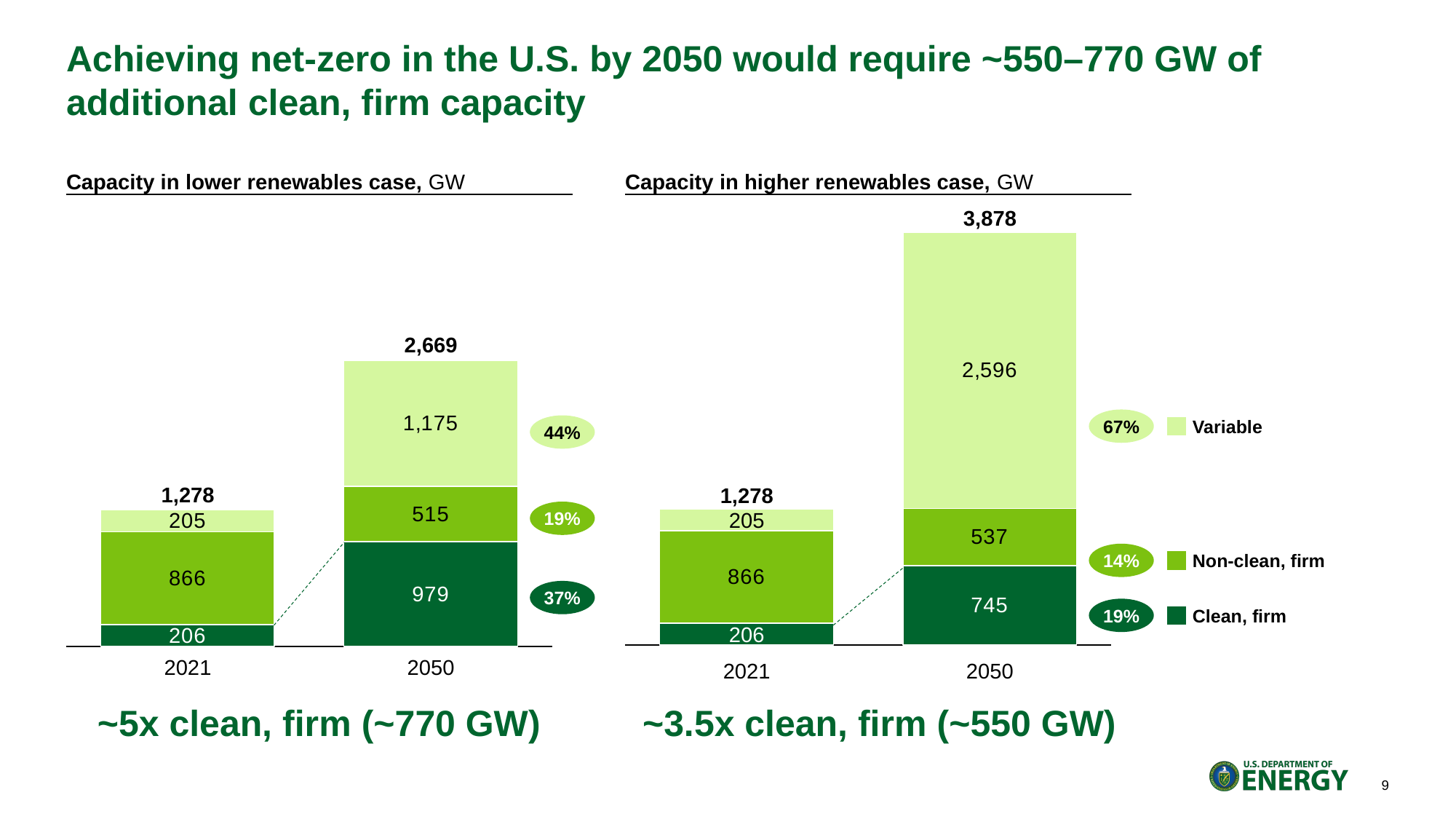
What kind of chart is the 'Capacity in higher renewables case' chart? Stacked bar chart In the 'Capacity in lower renewables case' chart, which is larger in 2050: Variable or Non-clean, firm capacity? Variable In the 'Capacity in higher renewables case' chart, what is the total capacity of the 2050 bar? 3,878 In the 'Capacity in higher renewables case' chart, what share of the 2050 bar is Variable capacity? 67% In the 'Capacity in higher renewables case' chart, what is the difference between the Clean, firm capacity in 2050 and in 2021? 539 In the 'Capacity in lower renewables case' chart, how many years are shown on the x axis? 2 In the 'Capacity in lower renewables case' chart, what is the Non-clean, firm capacity in 2021? 866 How many series does the legend list? 3 In the 'Capacity in lower renewables case' chart, what is the Clean, firm capacity in 2050? 979 In the 'Capacity in lower renewables case' chart, what share of the 2050 bar is Clean, firm capacity? 37% In the 'Capacity in higher renewables case' chart, what is the Variable capacity in 2050? 2,596 In the 'Capacity in lower renewables case' chart, what is the total capacity of the 2050 bar? 2,669